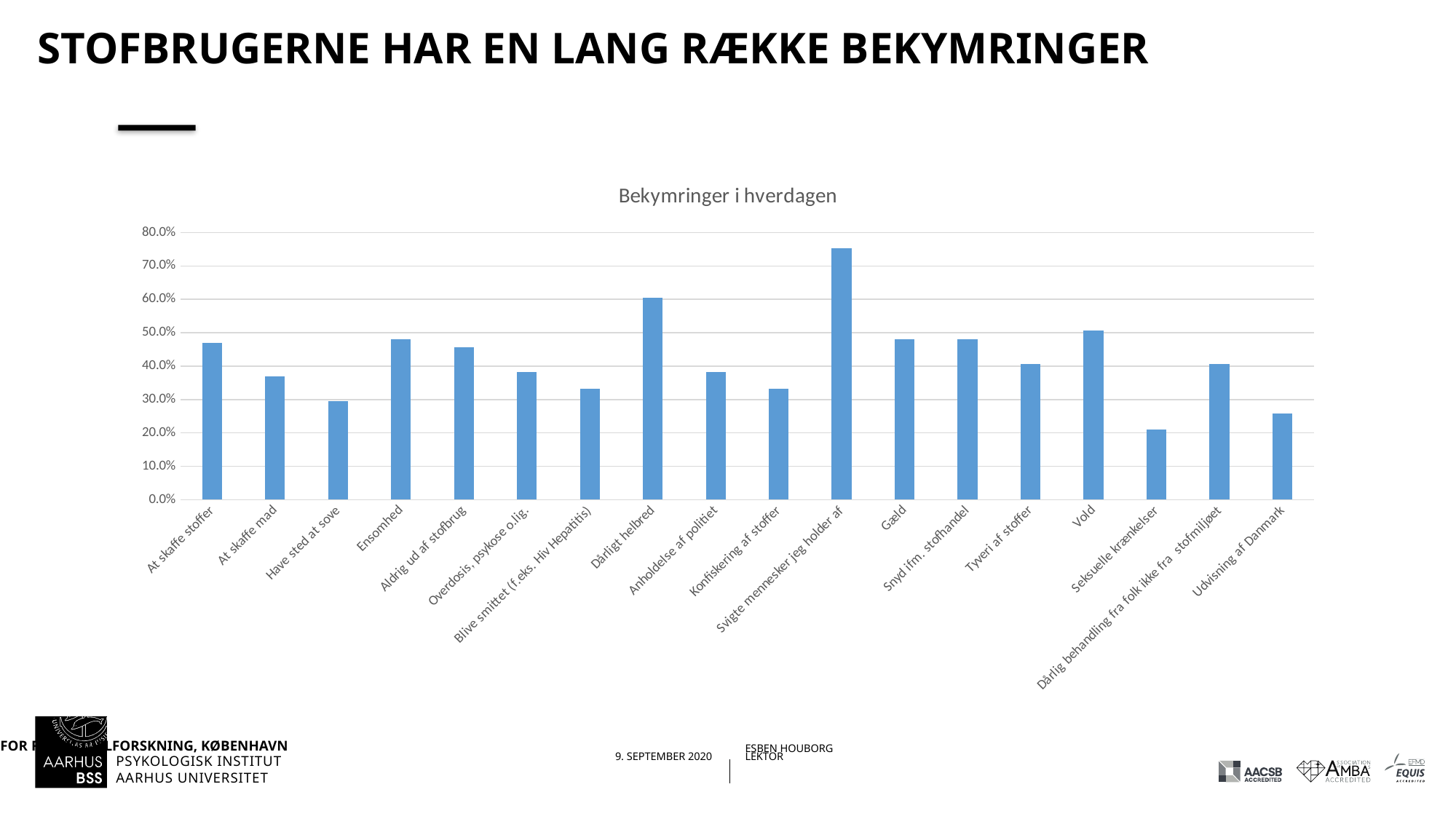
Is the value for Udvisning af Danmark greater or less than 30.0%? less What is the title of the chart? Bekymringer i hverdagen Is the value for At skaffe mad greater or less than 40.0%? less Which is larger, the value for Dårligt helbred or the value for Gæld? Dårligt helbred Which is larger, the value for At skaffe stoffer or the value for At skaffe mad? At skaffe stoffer Is the value for Svigte mennesker jeg holder af greater or less than 70.0%? greater What kind of chart is shown on the slide? Bar chart Which category has the lowest value in the chart? Seksuelle krænkelser How many categories are plotted on the x axis of the chart? 18 Which category has the highest value in the chart? Svigte mennesker jeg holder af